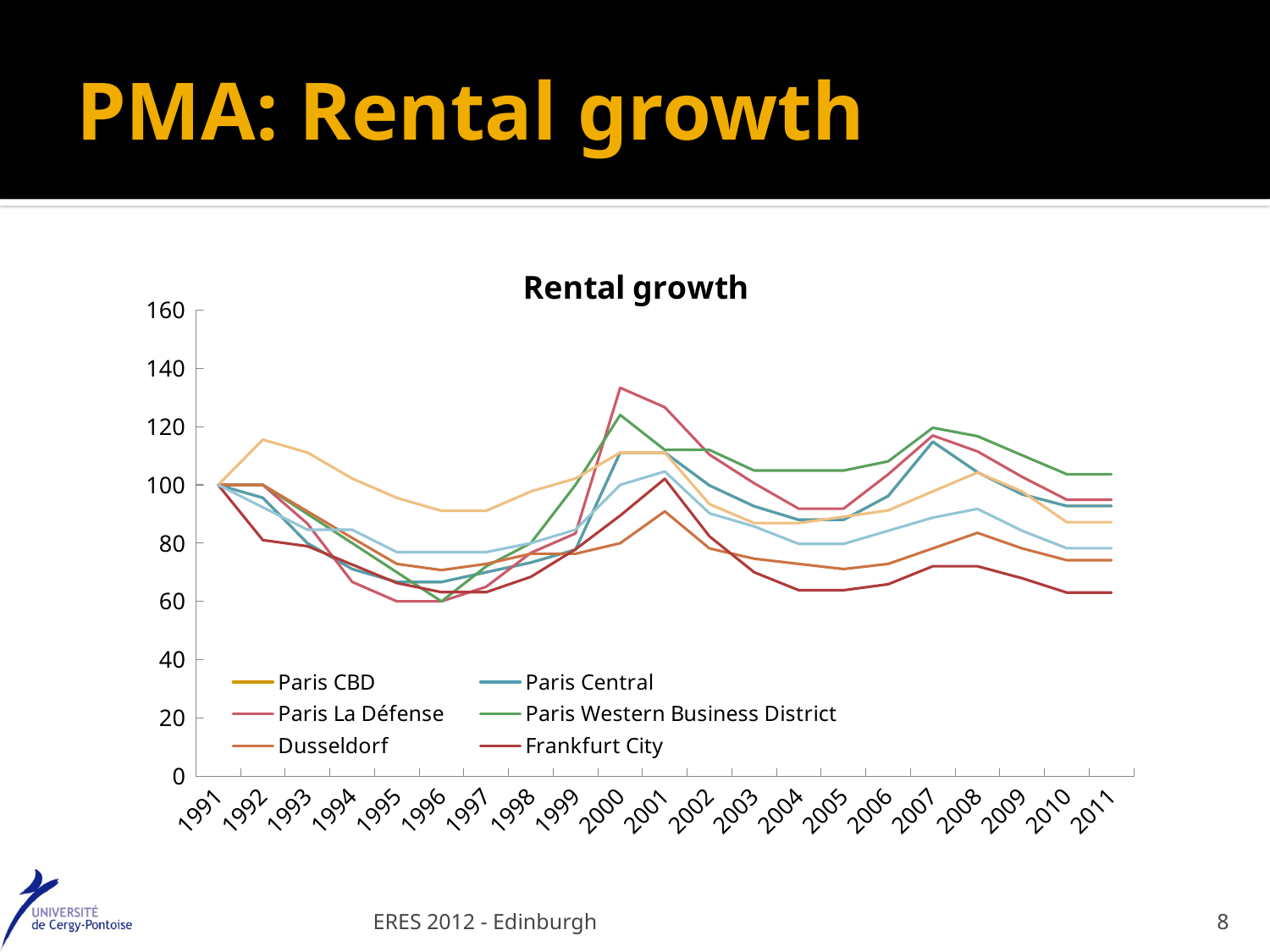
Which series has the highest value in 2000? Paris La Défense What is the title of the chart? Rental growth In 1992, which is larger: the value for Paris CBD or the value for Frankfurt City? Paris CBD How many years are shown along the x axis? 21 Does the Frankfurt City line rise or fall from 2008 to 2011? fall Which series has the lowest value in 2004? Frankfurt City What kind of chart is shown on the slide? line chart How many series does the legend list? 6 Which series has the lowest value in 2011? Frankfurt City Is the value for Paris La Défense in 2000 greater or less than 120? greater Is the value for Frankfurt City in 2011 greater or less than 80? less Which series is drawn in green? Paris Western Business District